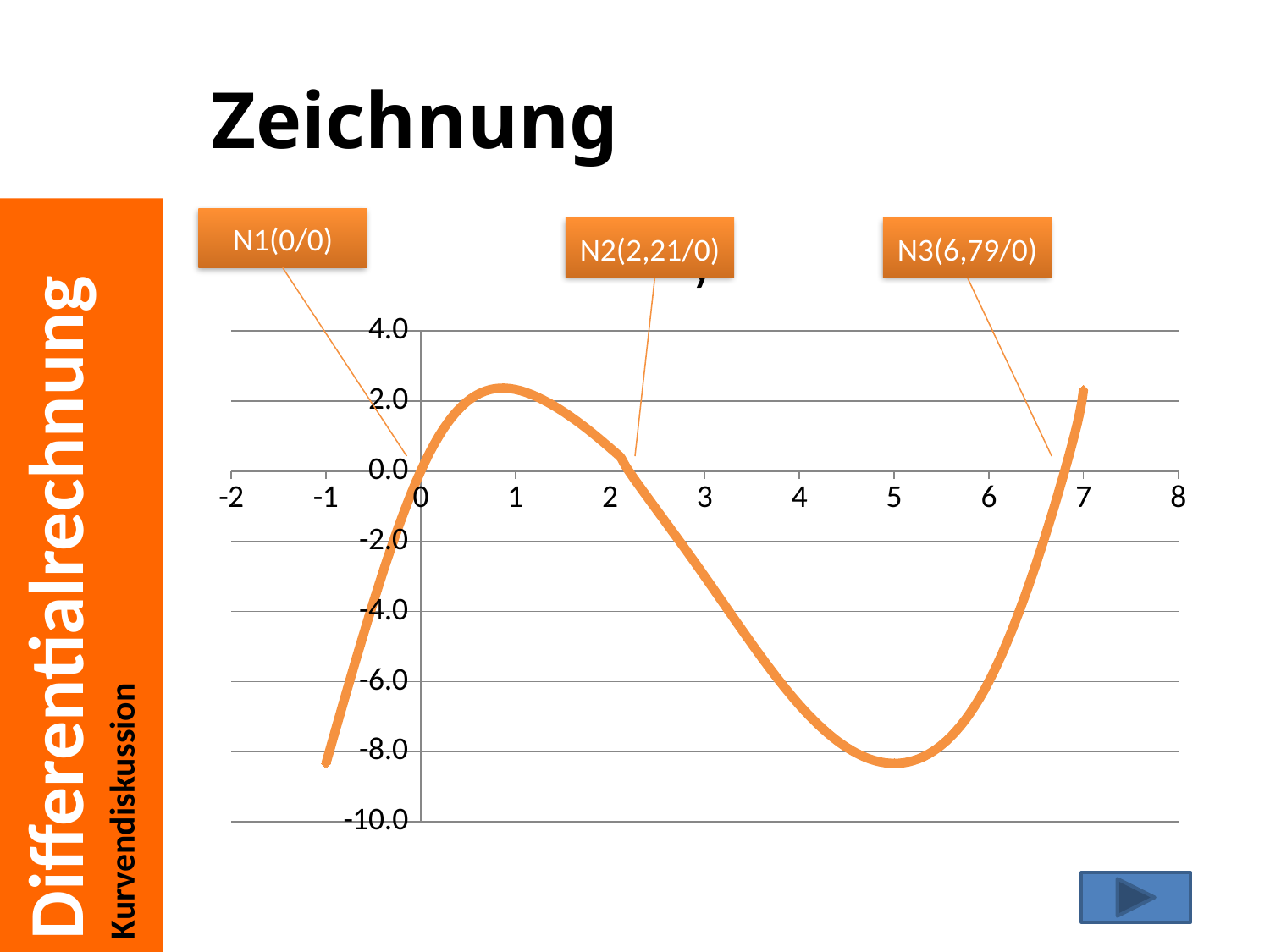
What colour is the plotted curve? orange Is the value of the curve at x = 1 greater or less than 0.0? greater What is the x-coordinate of the zero N3? 6,79 Does the curve rise or fall between x = 1 and x = 5? fall What kind of chart is shown on the slide? line chart What are the coordinates given for N1? (0/0) Is the value of the curve at x = 5 greater or less than -6.0? less Is the value of the curve at x = -1 greater or less than -6.0? less How many zeros (Nullstellen) are labelled on the chart? 3 What are the coordinates given for N2? (2,21/0) Near which x-axis tick does the curve reach its lowest point? 5